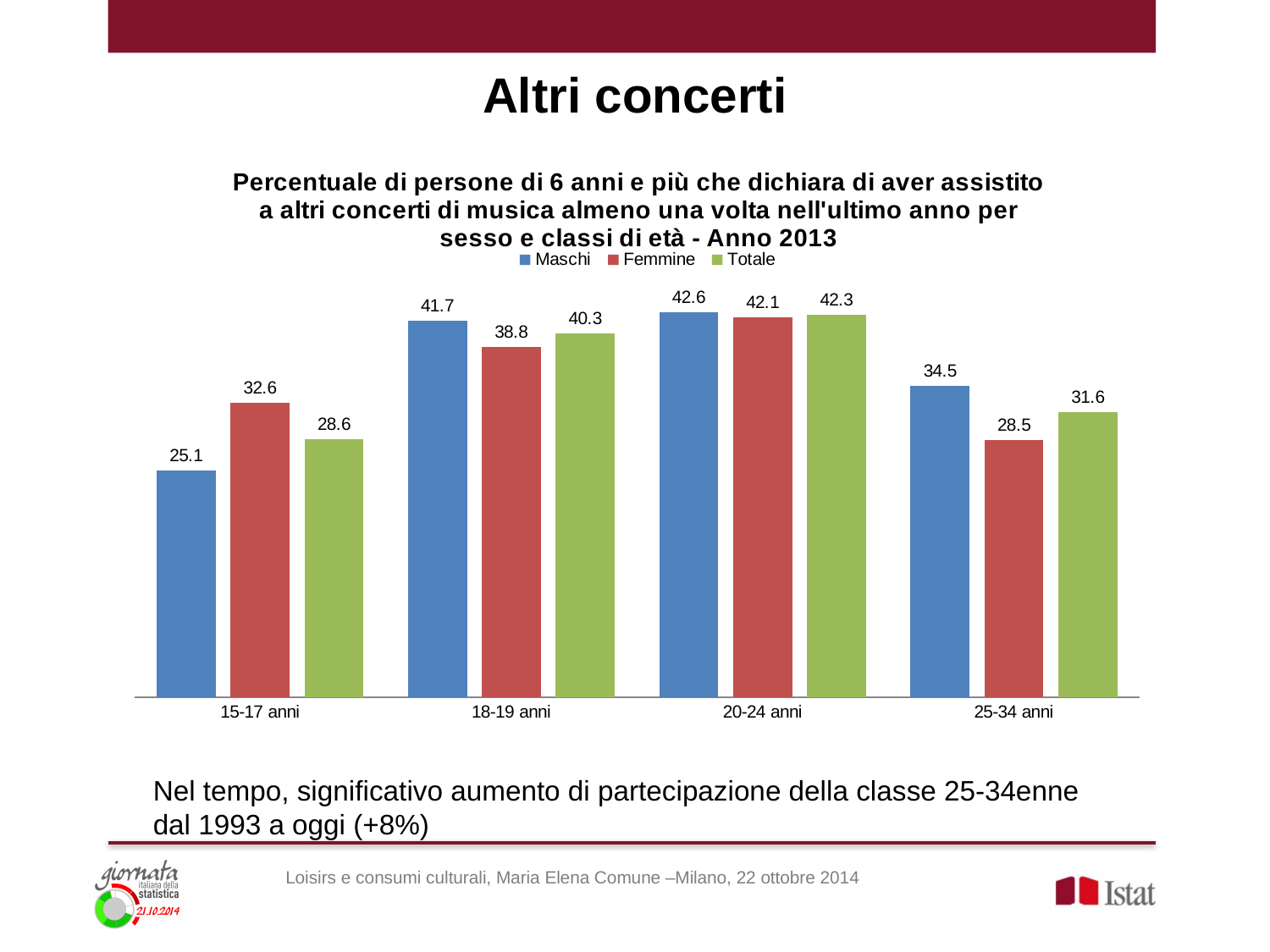
Which is larger in the 15-17 anni age group, the Maschi value or the Femmine value? Femmine How many age groups are shown on the x axis? 4 What is the difference between the Maschi and Femmine values in the 25-34 anni age group? 6.0 How many series does the legend list? 3 What is the difference between the Femmine values for 15-17 anni and 18-19 anni? 6.2 What is the value for Maschi in the 15-17 anni age group? 25.1 Which colour represents the Totale series? green What kind of chart is shown on the slide? bar chart Which age group has the highest value for Maschi? 20-24 anni Which age group has the lowest value for Totale? 15-17 anni What is the value for Femmine in the 18-19 anni age group? 38.8 What is the value for Totale in the 25-34 anni age group? 31.6